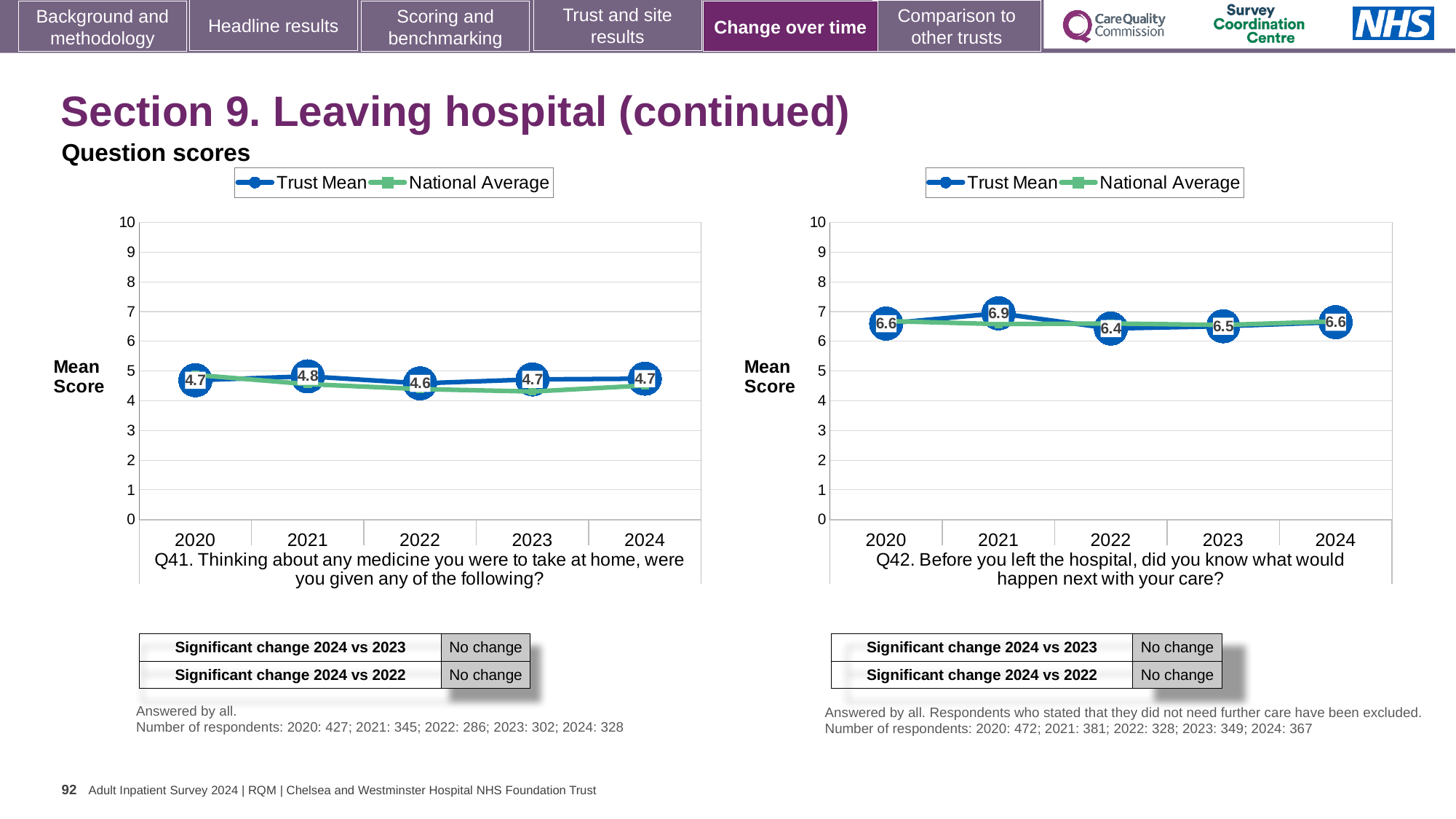
In the Q42 chart, which year has the lowest Trust Mean score? 2022 In the Q42 chart, what is the Trust Mean score for 2022? 6.4 In the Q42 chart, what is the Trust Mean score for 2021? 6.9 In the Q42 chart, what is the difference between the Trust Mean scores for 2021 and 2022? 0.5 In the Q41 chart, is the Trust Mean score for 2024 greater or less than 5? less In the Q41 chart, what is the Trust Mean score for 2021? 4.8 In the Q41 chart, which year has the highest Trust Mean score? 2021 In the Q42 chart, which year has the highest Trust Mean score? 2021 How many years are plotted on the x axis of the Q42 chart? 5 In the Q41 chart, what is the Trust Mean score for 2022? 4.6 How many series does the legend of the Q41 chart list? 2 What type of chart is used for Q42? Line chart